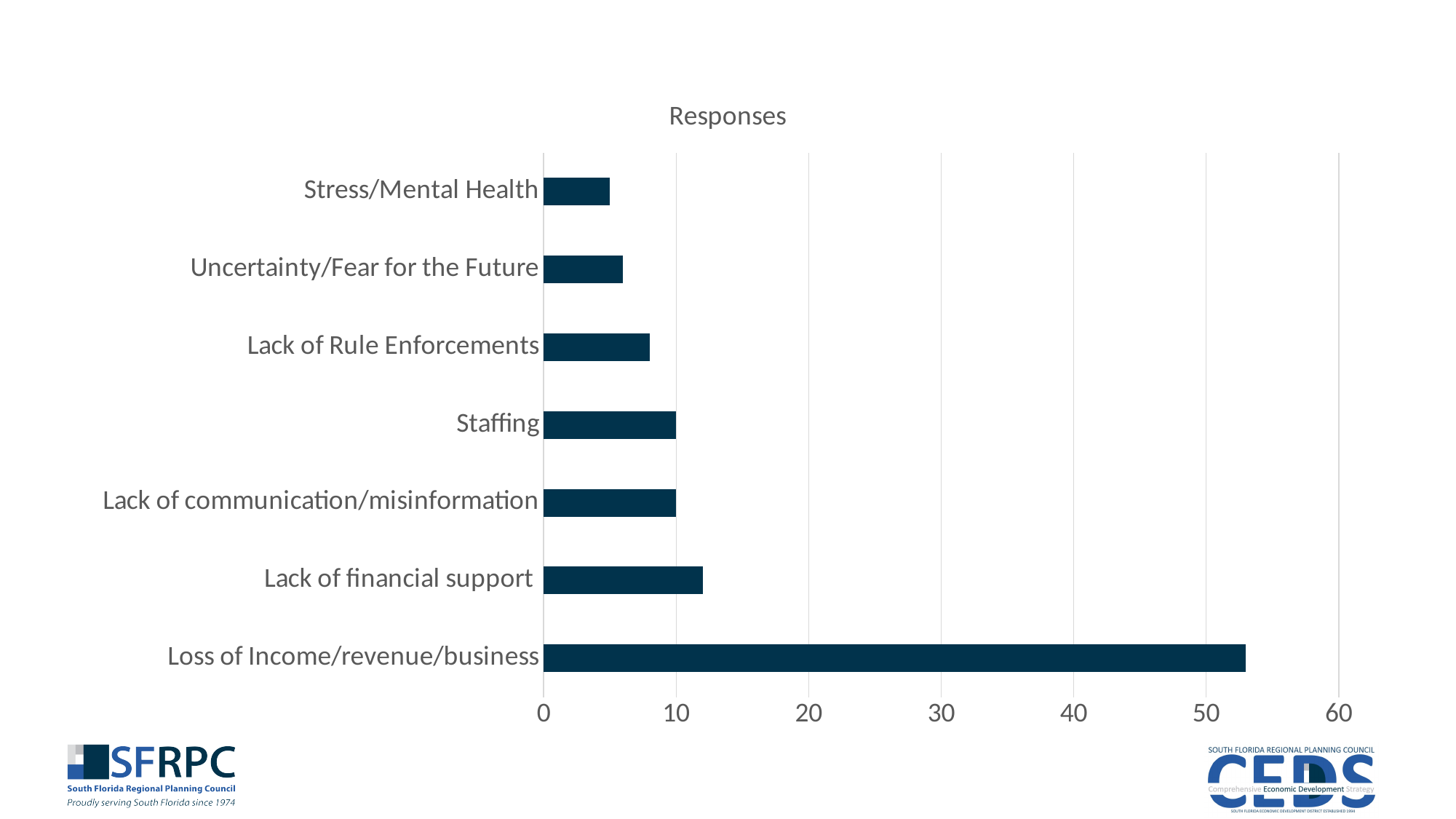
How many categories are shown in the chart? 7 Is the value for Loss of Income/revenue/business greater or less than 50? greater What is the title of the chart? Responses What is the value for Staffing? 10 Which has more responses, Loss of Income/revenue/business or Lack of financial support? Loss of Income/revenue/business Which has more responses, Lack of Rule Enforcements or Stress/Mental Health? Lack of Rule Enforcements Is the value for Lack of Rule Enforcements greater or less than 10? less Is the value for Uncertainty/Fear for the Future greater or less than 10? less What kind of chart is shown on the slide? bar chart Which category has the highest number of responses? Loss of Income/revenue/business